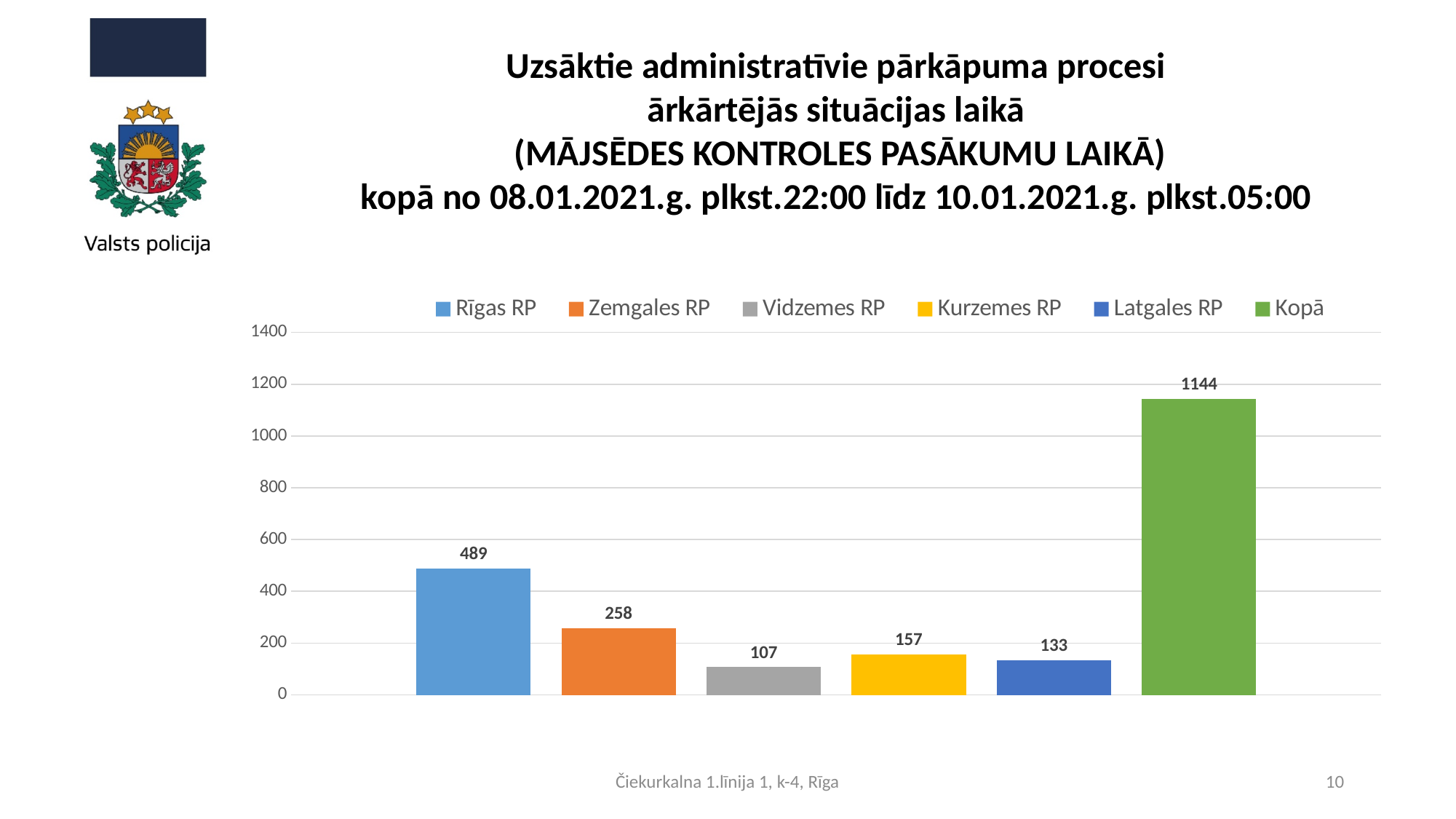
What is the value for Vidzemes RP? 107 What is the value for Rīgas RP? 489 What is the value for Kurzemes RP? 157 What is the value for Latgales RP? 133 What is the value for Kopā? 1144 What is the value for Zemgales RP? 258 Which bar has the lowest value? Vidzemes RP What is the difference between the values for Rīgas RP and Zemgales RP? 231 Which is larger, the value for Kurzemes RP or Latgales RP? Kurzemes RP Which of the regional police bars (excluding Kopā) has the highest value? Rīgas RP What kind of chart is shown on the slide? Bar chart How many series does the legend list? 6